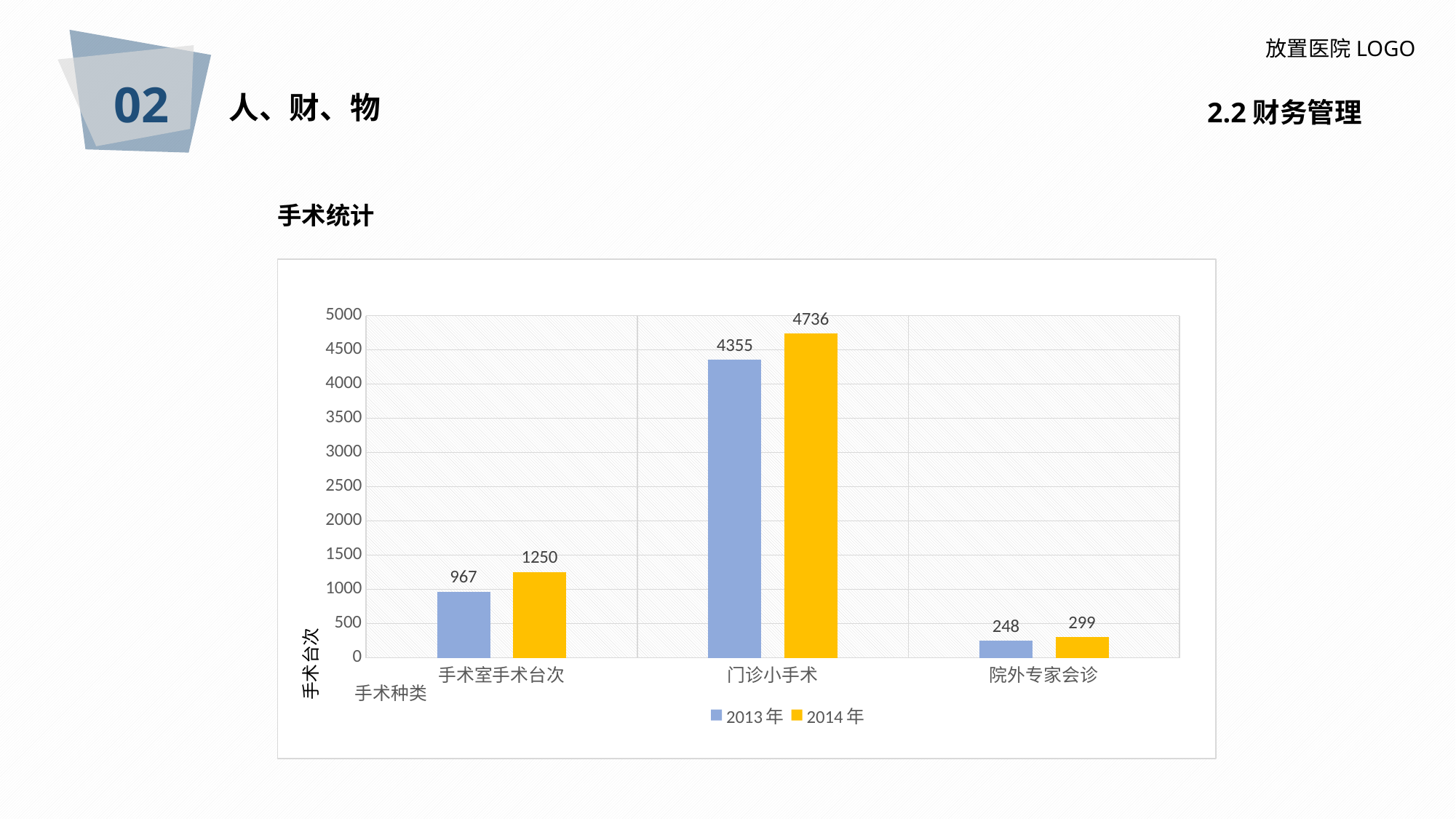
What is the difference between the 2014 年 and 2013 年 values for 手术室手术台次? 283 What kind of chart is shown on the slide? bar chart What is the value for 门诊小手术 in the 2014 年 series? 4736 Which category has the lowest value in the 2013 年 series? 院外专家会诊 Which category has the highest value in the 2014 年 series? 门诊小手术 What is the value for 院外专家会诊 in the 2013 年 series? 248 What is the title of the chart? 手术统计 Which is larger for 院外专家会诊: the 2013 年 value or the 2014 年 value? 2014 年 What is the difference between the 2014 年 and 2013 年 values for 门诊小手术? 381 How many categories are shown on the x axis? 3 What is the value for 手术室手术台次 in the 2013 年 series? 967 How many series does the legend list? 2